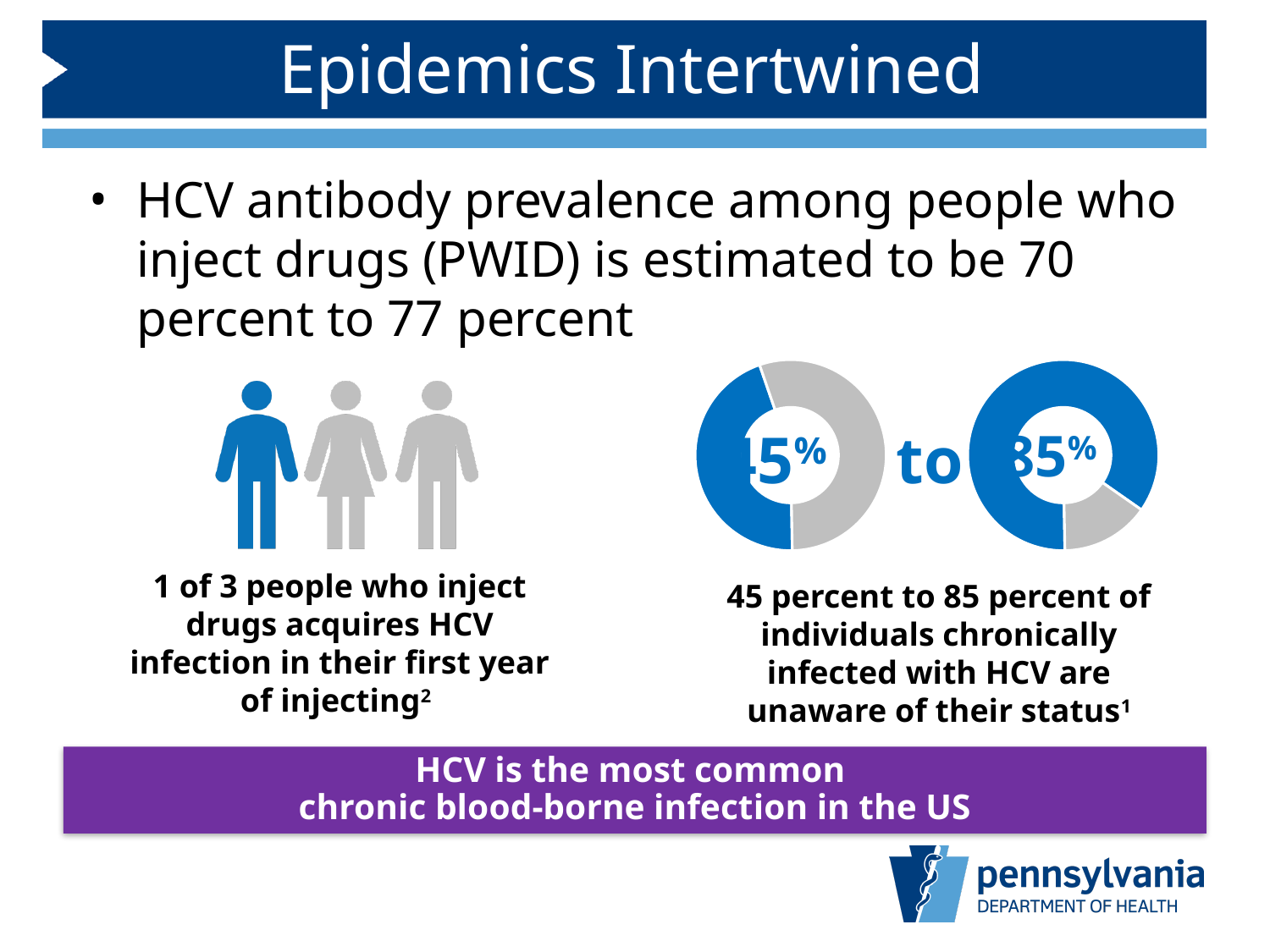
Is the value shown in the right donut chart greater or less than 50%? greater In the people-icon graphic on the left, how many of the three figures are coloured blue? 1 What percentage is shown in the left donut chart? 45% Is the value shown in the left donut chart greater or less than 50%? less What kind of charts are the two circular charts on the right side of the slide? Donut (pie) charts What share of the left donut chart is filled in blue? 45% What colour is used for the filled portion of the donut charts? Blue How many donut charts are shown on the slide? 2 What is the difference between the value in the right donut chart and the value in the left donut chart? 40 percentage points What range do the two donut charts together represent, according to the caption beneath them? 45 percent to 85 percent of individuals chronically infected with HCV are unaware of their status Which donut chart shows the larger value, the left one or the right one? The right one What percentage is shown in the right donut chart? 85%